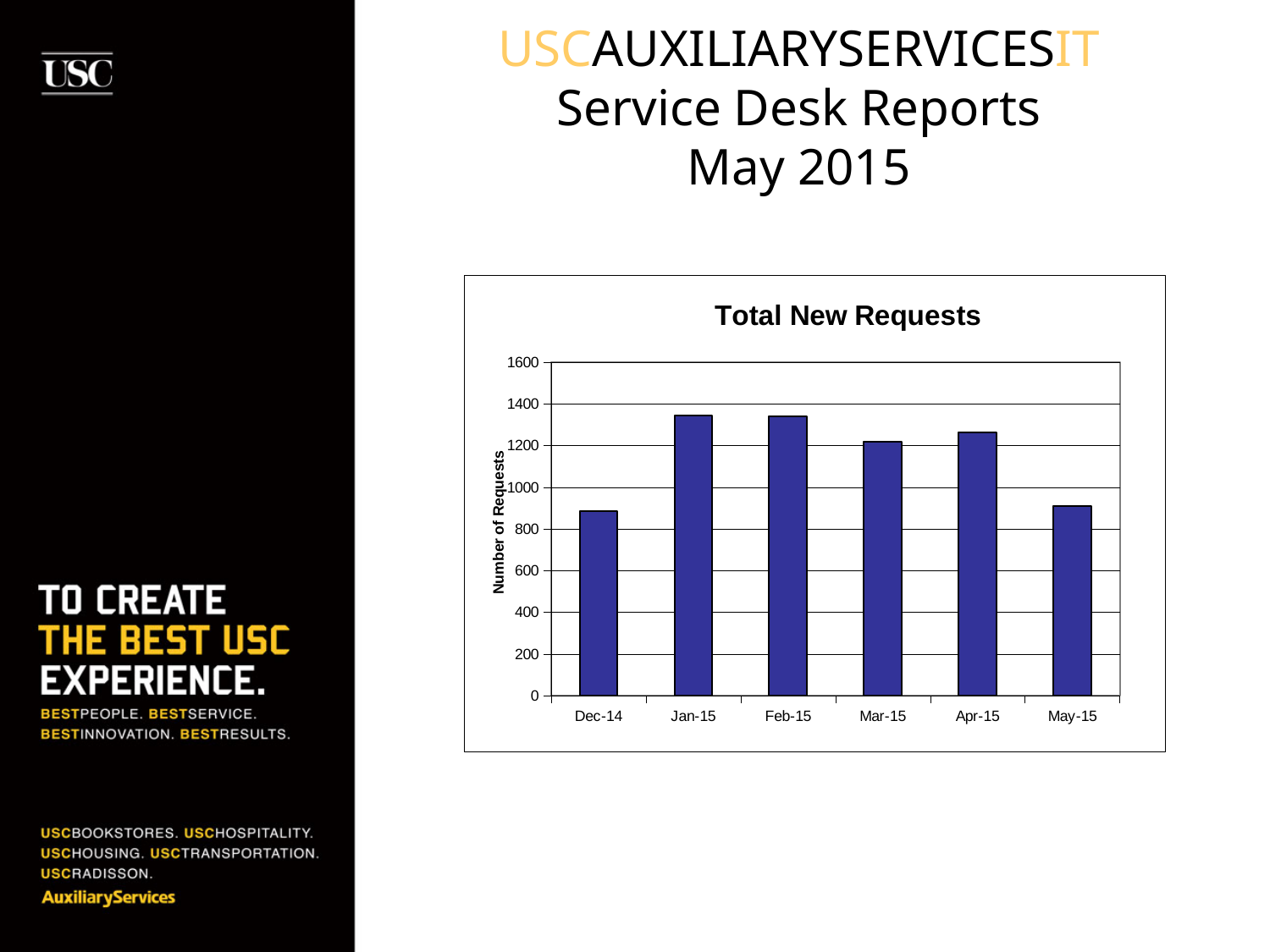
Is the value for May-15 greater or less than 1000? less What kind of chart is shown on the slide? bar chart Is the value for Apr-15 greater or less than 1400? less Is the value for Mar-15 greater or less than 1000? greater Does the number of requests rise or fall from Dec-14 to Jan-15? rise Which has a higher number of requests, Feb-15 or May-15? Feb-15 What is the label of the vertical axis in the Total New Requests chart? Number of Requests What is the title of the chart on the slide? Total New Requests Which has a higher number of requests, Jan-15 or Mar-15? Jan-15 How many months are shown on the x axis of the Total New Requests chart? 6